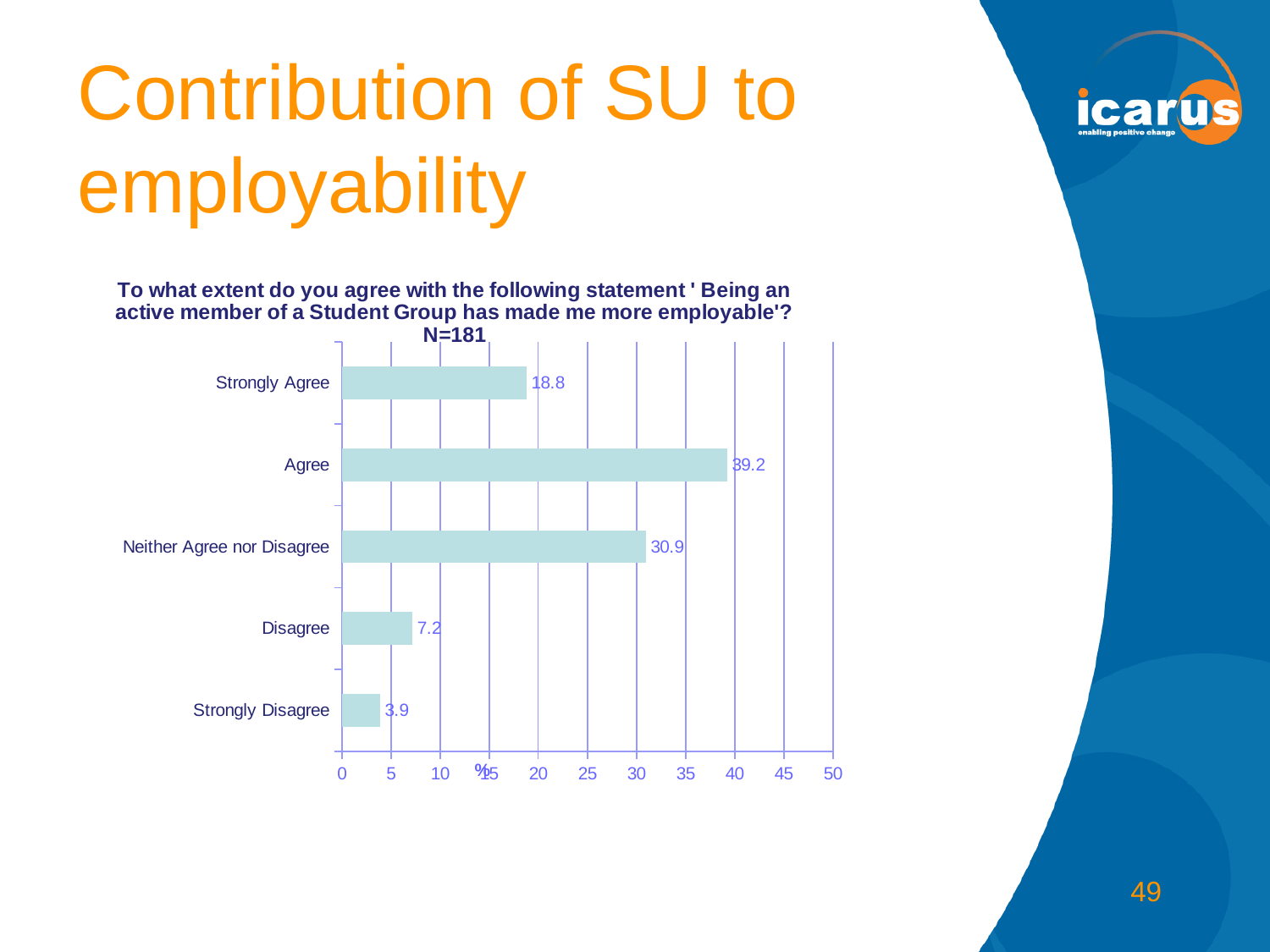
What is the value for Strongly Agree? 18.8 Which category has the highest value? Agree What is the value for Agree? 39.2 What is the value for Neither Agree nor Disagree? 30.9 What is the value for Strongly Disagree? 3.9 What kind of chart is shown on the slide? bar chart Which is larger, the value for Strongly Agree or the value for Disagree? Strongly Agree What is the difference between the values for Agree and Neither Agree nor Disagree? 8.3 Is the value for Neither Agree nor Disagree greater or less than 25? greater What sample size (N) is stated in the chart title? N=181 How many categories are shown on the chart? 5 Which category has the lowest value? Strongly Disagree